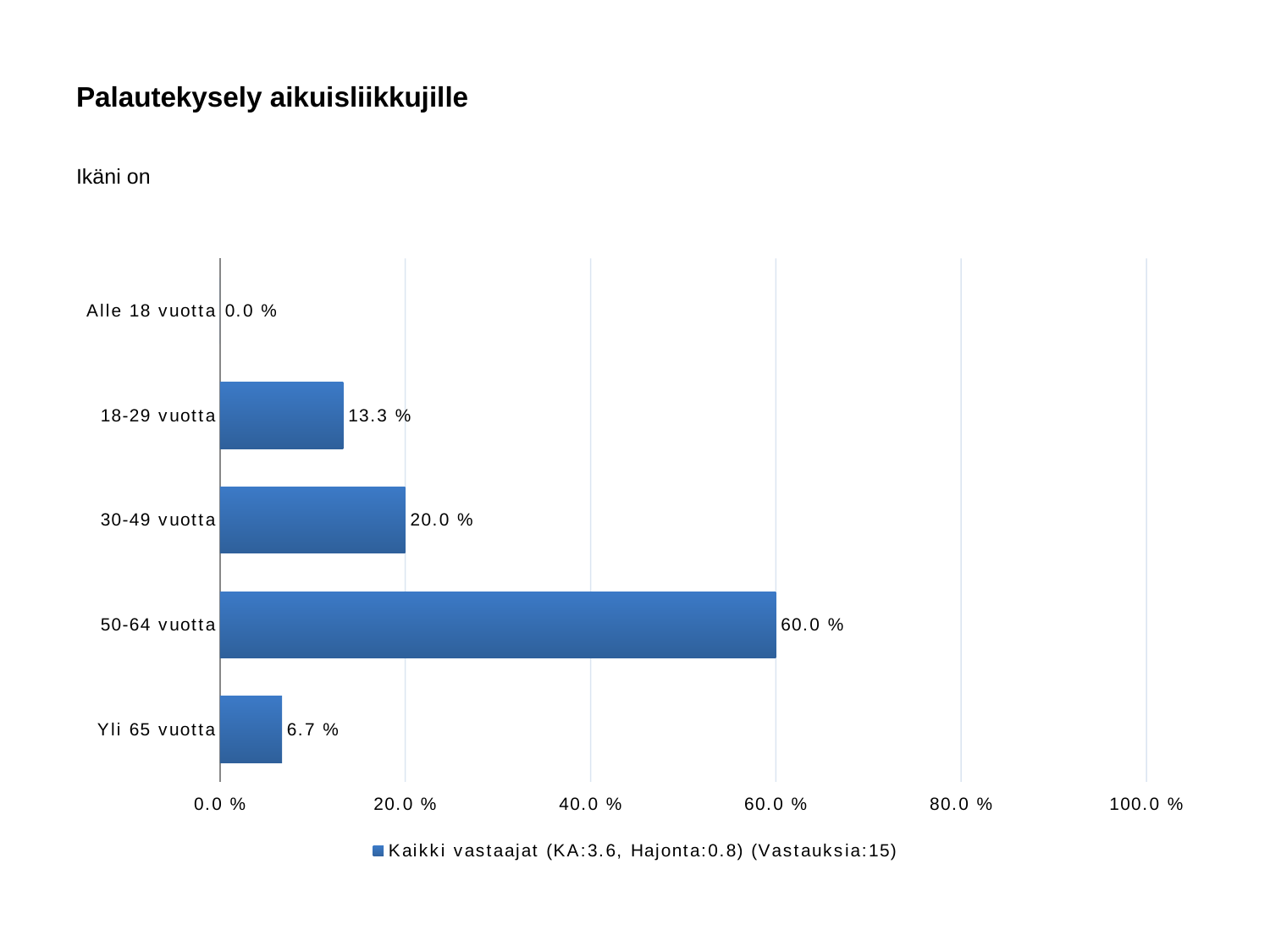
What kind of chart is shown on the slide? Bar chart How many age categories are shown in the chart? 5 What is the value for Alle 18 vuotta? 0.0 % Which age category has the lowest value? Alle 18 vuotta Is the value for 50-64 vuotta greater or less than 40.0 %? greater Which age category has the highest value? 50-64 vuotta What is the difference between the values for 50-64 vuotta and 30-49 vuotta? 40.0 % What is the value for Yli 65 vuotta? 6.7 % What is the value for 50-64 vuotta? 60.0 % Which is larger, the value for 30-49 vuotta or the value for 18-29 vuotta? 30-49 vuotta How many responses (Vastauksia) does the legend state? 15 What is the value for 18-29 vuotta? 13.3 %